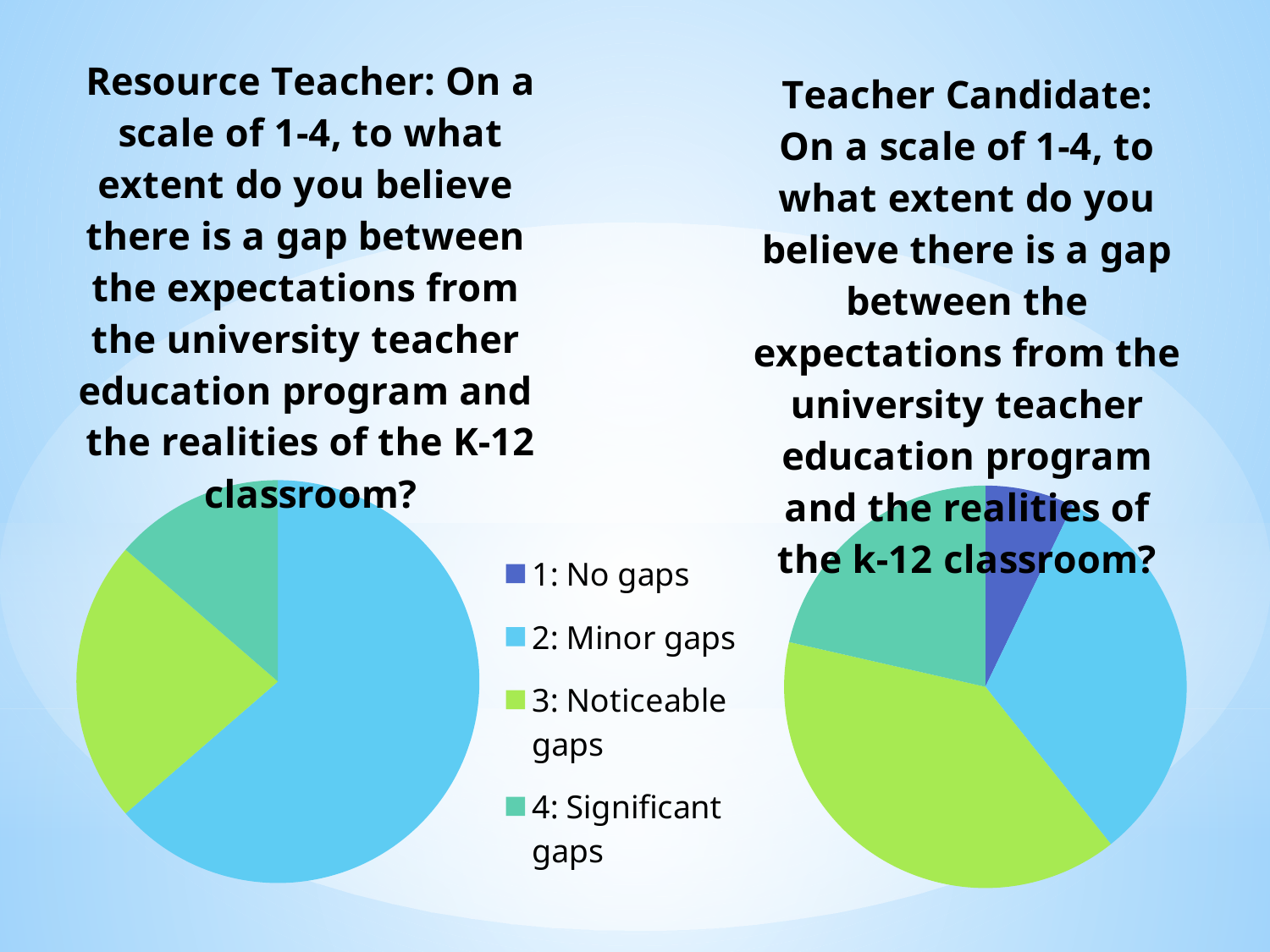
How many categories does the shared legend list? 4 In the Teacher Candidate chart on the right, which is larger: the slice for 3: Noticeable gaps or the slice for 1: No gaps? 3: Noticeable gaps What kind of chart is the Resource Teacher chart on the left? Pie chart In the Resource Teacher chart on the left, which is larger: the slice for 2: Minor gaps or the slice for 3: Noticeable gaps? 2: Minor gaps In the Teacher Candidate chart on the right, which category has the smallest slice? 1: No gaps In the Teacher Candidate chart on the right, which is larger: the slice for 1: No gaps or the slice for 4: Significant gaps? 4: Significant gaps Which legend entry is shown in dark blue? 1: No gaps How many slices are visible in the Resource Teacher chart on the left? 3 In the Resource Teacher chart on the left, which category has the largest slice? 2: Minor gaps Which legend category does not appear as a visible slice in the Resource Teacher chart on the left? 1: No gaps How many slices are visible in the Teacher Candidate chart on the right? 4 What kind of chart is the Teacher Candidate chart on the right? Pie chart